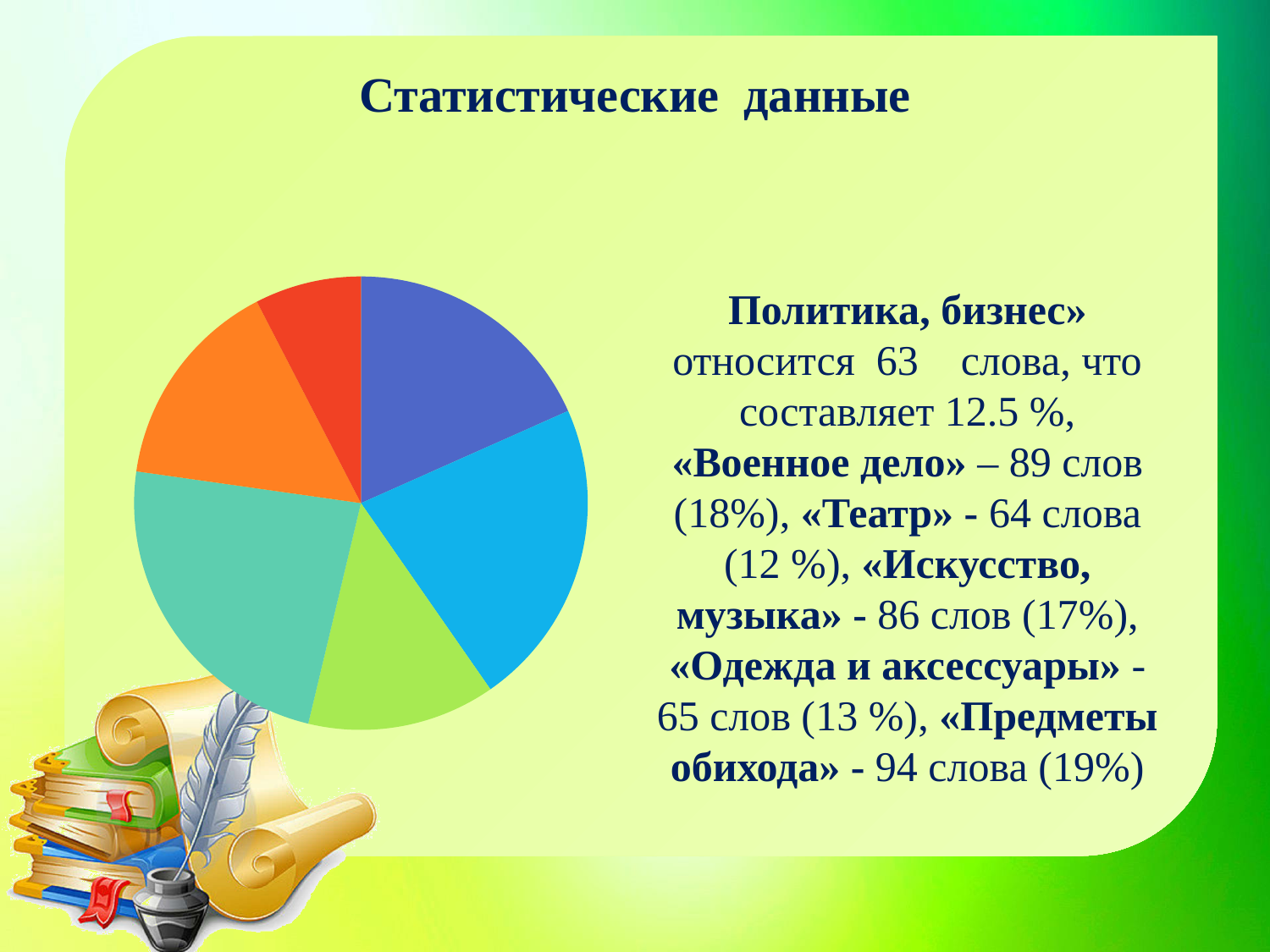
Which category has the smallest number of words according to the slide text? Политика, бизнес Which has more words according to the slide text, «Театр» or «Искусство, музыка»? Искусство, музыка Does the pie chart have a legend or data labels on its slices? No According to the slide text, how many words belong to the category «Военное дело»? 89 слов According to the slide text, what share does «Одежда и аксессуары» have? 13 % Which category has the largest number of words according to the slide text? Предметы обихода How many slices does the pie chart have? 6 What is the title of the slide containing the pie chart? Статистические данные What is the difference in word count between «Предметы обихода» and «Политика, бизнес» according to the slide text? 31 What kind of chart is shown on the slide? pie chart According to the slide text, what percentage does «Политика, бизнес» make up? 12.5 % According to the slide text, how many words belong to «Предметы обихода»? 94 слова